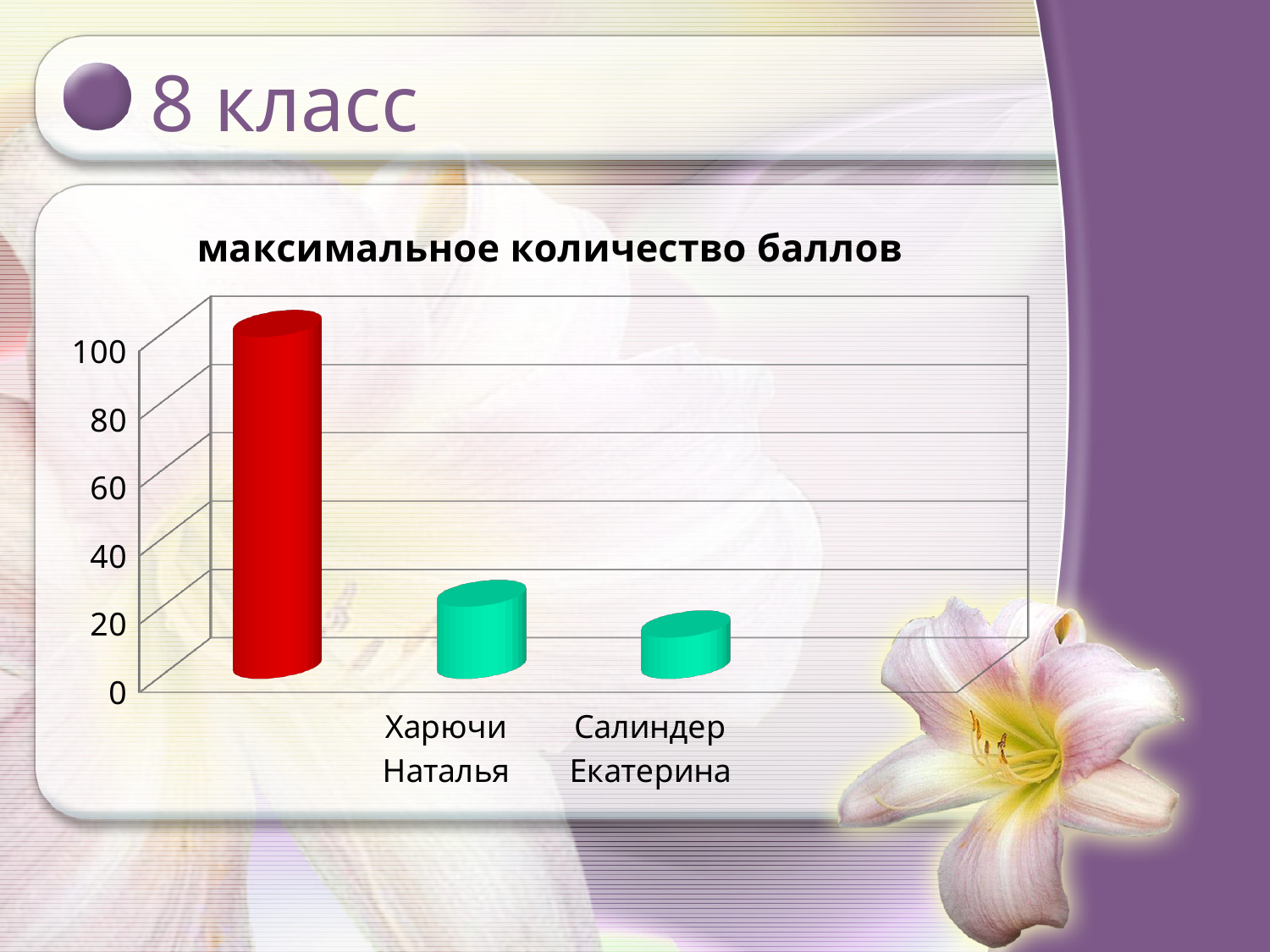
Is the value for Салиндер Екатерина greater or less than 40? less What is the title of the chart? максимальное количество баллов Which labelled category has the lowest value? Салиндер Екатерина What kind of chart is shown on the slide? bar chart Is the value for Харючи Наталья greater or less than 60? less What is the highest tick value shown on the vertical axis? 100 How many bars are plotted in the chart? 3 Is the value for Харючи Наталья greater or less than 40? less Which is larger, the value for Харючи Наталья or the value for Салиндер Екатерина? Харючи Наталья